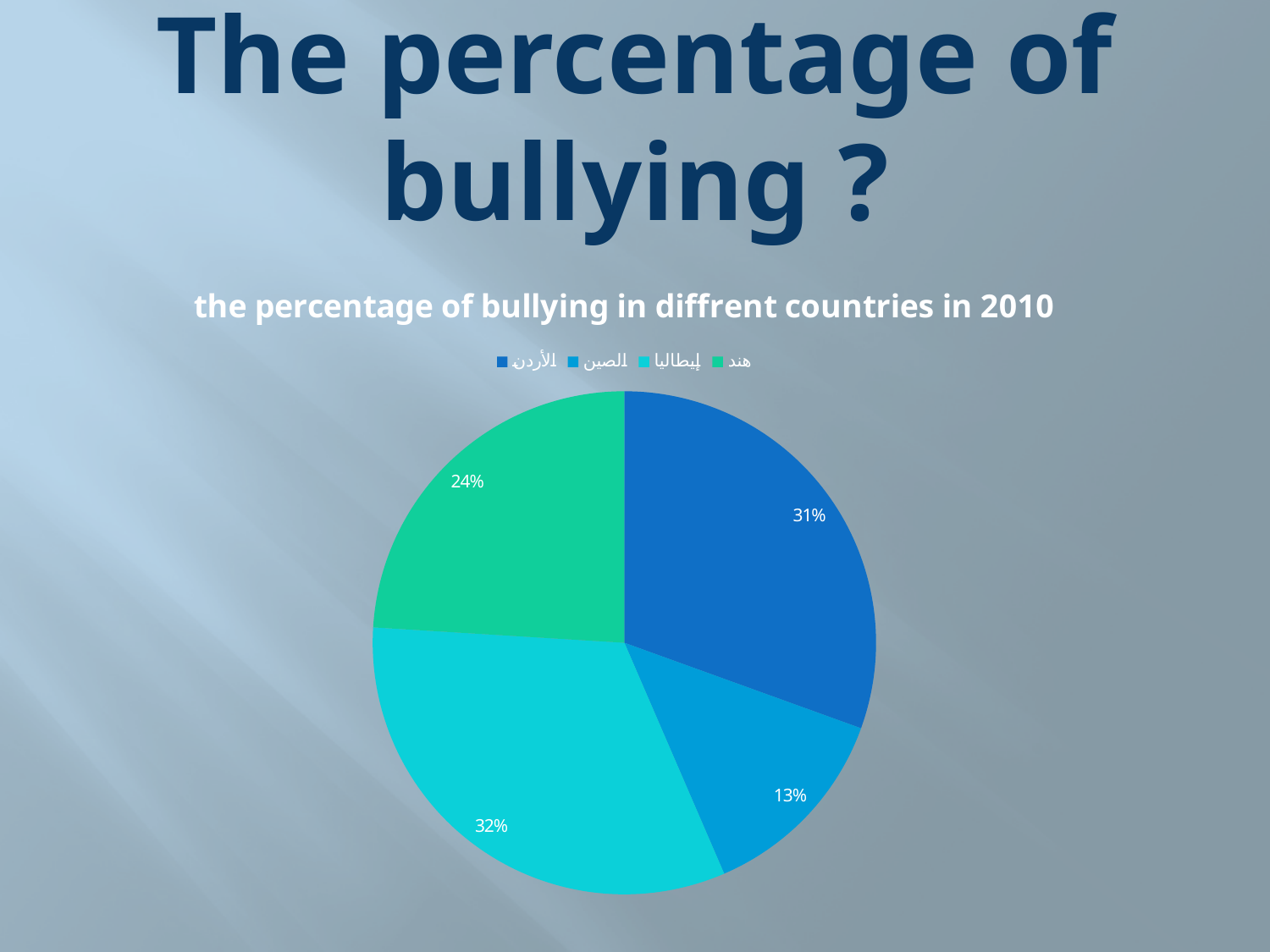
What percentage is shown for إيطاليا? 32% What percentage is shown for الأردن? 31% How many entries does the legend list? 4 Which country has the largest slice of the pie? إيطاليا What is the difference between the percentages for هند and الصين? 11% How many slices does the pie chart have? 4 What percentage is shown for هند? 24% What kind of chart is shown on the slide? pie chart What percentage is shown for الصين? 13% Which is larger, the slice for الأردن or the slice for هند? الأردن What is the title of the chart? the percentage of bullying in diffrent countries in 2010 Which country has the smallest slice of the pie? الصين